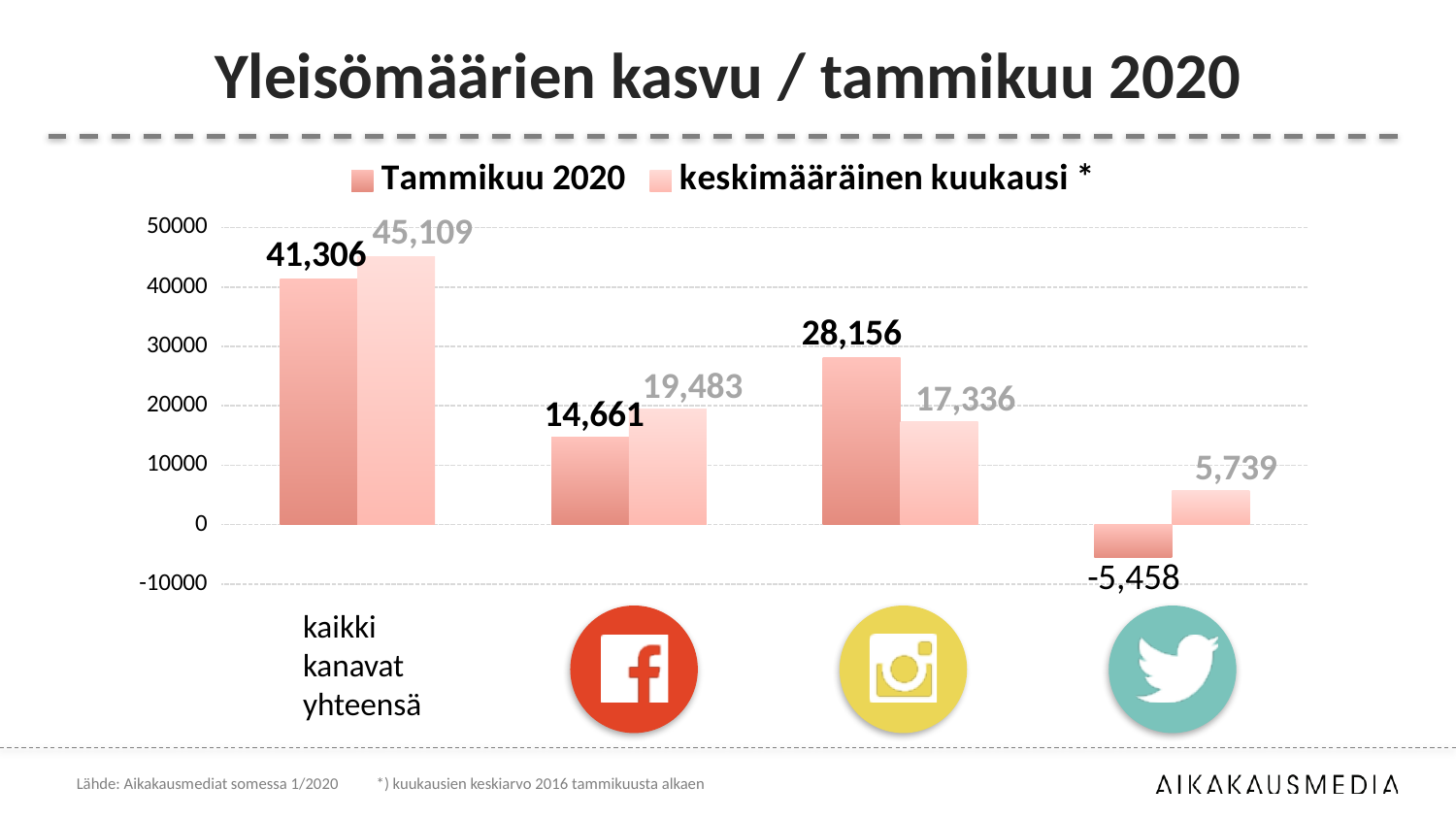
How many series does the legend list? 2 What is the keskimääräinen kuukausi value for the Facebook category? 19,483 What is the difference between the Tammikuu 2020 and keskimääräinen kuukausi values for the Instagram category? 10,820 What is the keskimääräinen kuukausi value for the Instagram category? 17,336 Which category has the lowest Tammikuu 2020 value? Twitter Which category has the highest keskimääräinen kuukausi value? kaikki kanavat yhteensä What is the Tammikuu 2020 value for kaikki kanavat yhteensä? 41,306 For the Facebook category, which is larger: the Tammikuu 2020 value or the keskimääräinen kuukausi value? keskimääräinen kuukausi What is the Tammikuu 2020 value for the Twitter category? -5,458 What kind of chart is shown on the slide? Bar chart How many categories are shown on the x axis? 4 What is the title of the slide? Yleisömäärien kasvu / tammikuu 2020